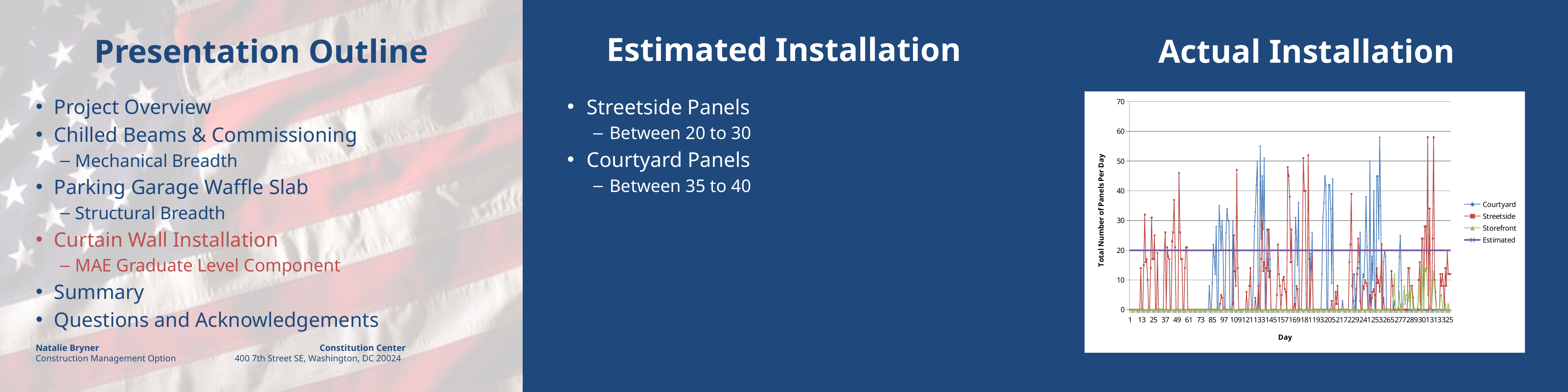
In the Actual Installation chart, are the Storefront values greater or less than 30? less In the Actual Installation chart, what value does the Estimated series hold across all days? 20 How many series does the legend of the Actual Installation chart list? 4 What kind of chart is shown under the 'Actual Installation' heading? line chart What series names appear in the legend of the Actual Installation chart? Courtyard, Streetside, Storefront, Estimated In the Actual Installation chart, is the Estimated line greater or less than 30? less In the Actual Installation chart, does the Estimated series rise, fall, or stay constant along the x axis? stay constant What is the y-axis title of the Actual Installation chart? Total Number of Panels Per Day